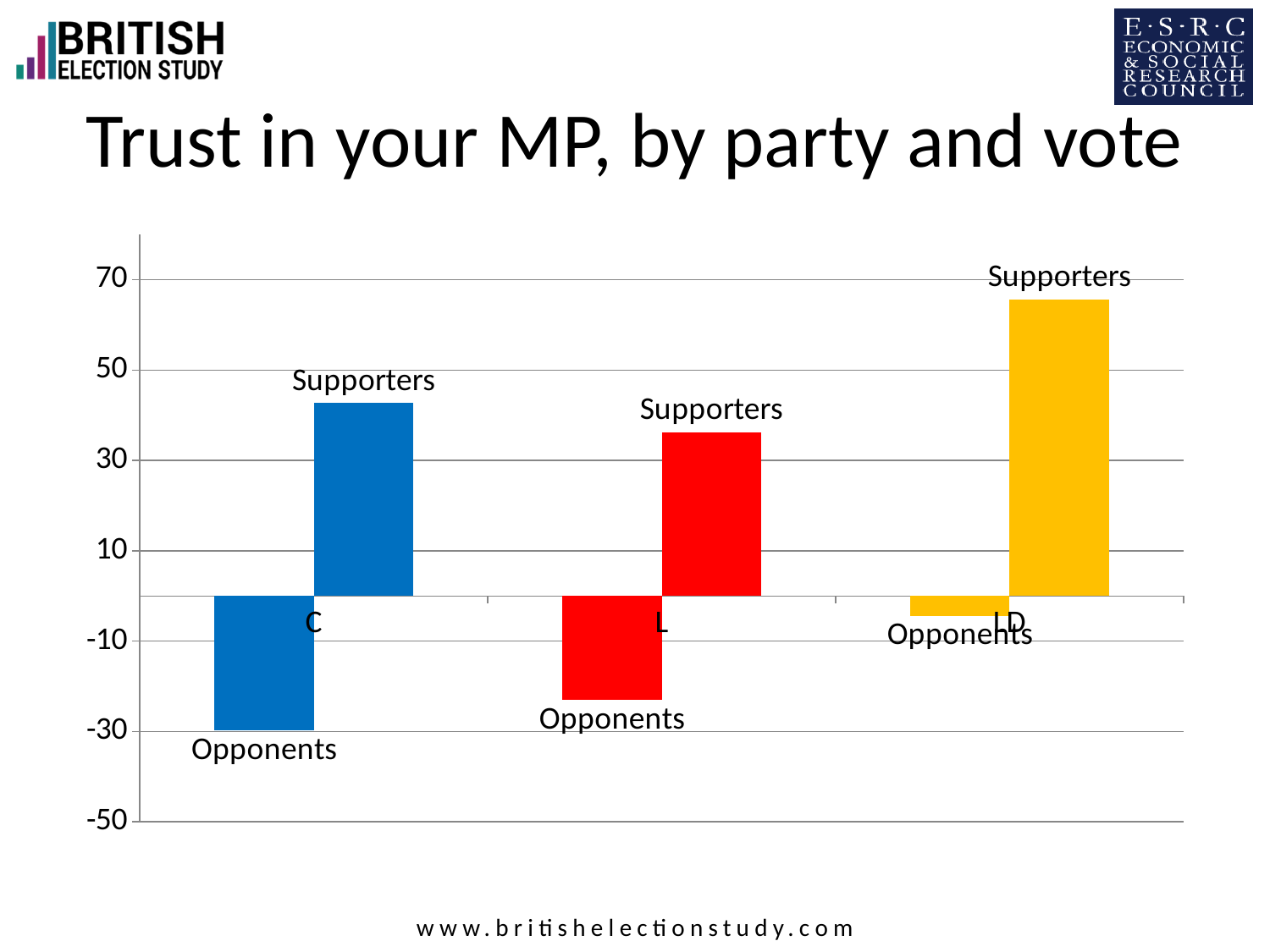
Is the value for LD Supporters greater or less than 50? greater Is the value for L Supporters greater or less than 30? greater How many party categories are shown on the x axis? 3 How many bars are plotted in the chart? 6 What kind of chart is shown on the slide? bar chart Which bar has the highest value in the chart? LD Supporters What is the title of the chart? Trust in your MP, by party and vote Is the value for C Supporters greater or less than 50? less Which is larger, the value for LD Opponents or the value for L Opponents? LD Opponents Which is larger, the value for C Supporters or the value for L Supporters? C Supporters Which bar has the lowest value in the chart? C Opponents